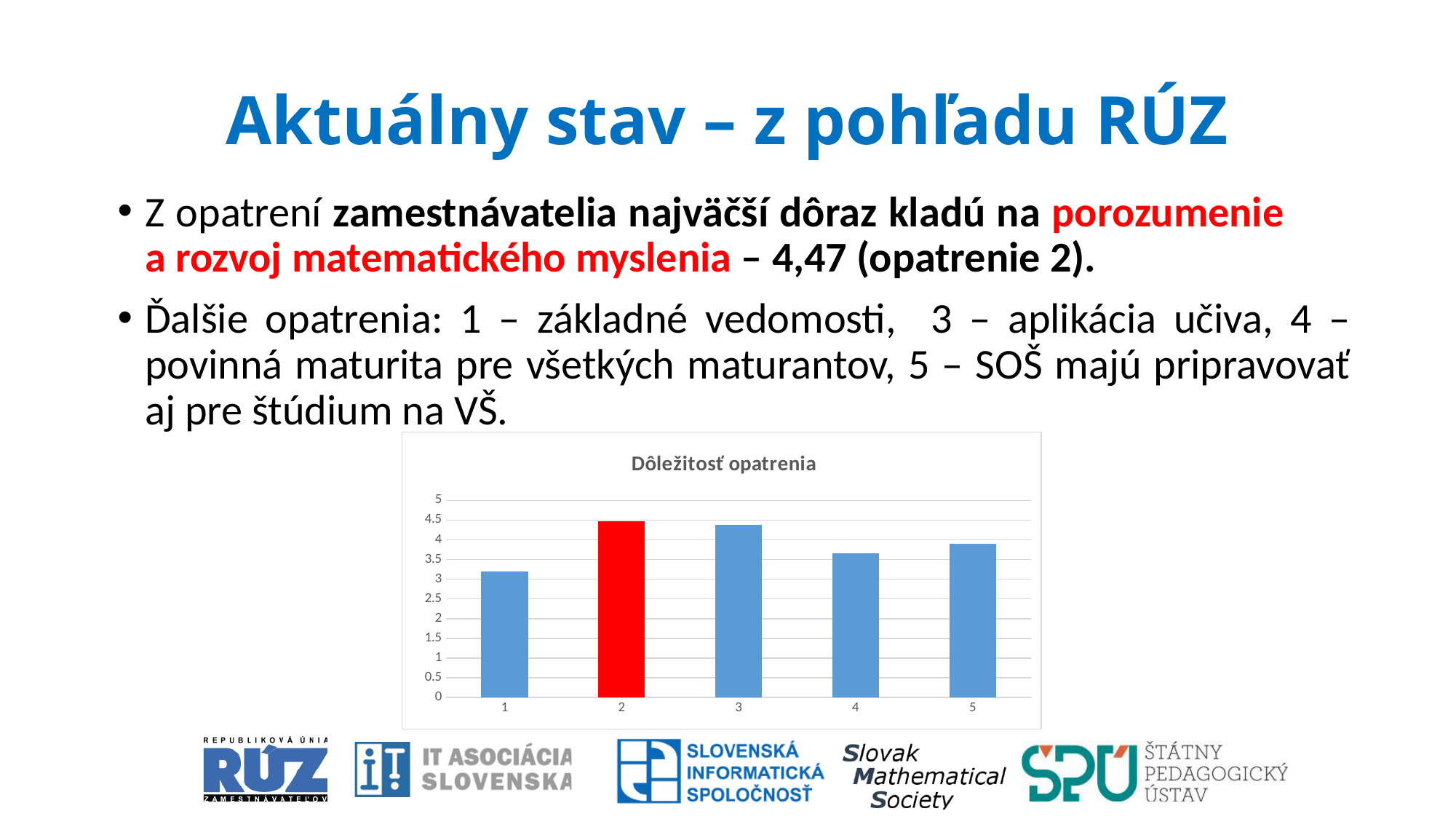
Which has the larger value, category 3 or category 5? 3 Which category has the highest bar in the chart? 2 Which bar in the chart is coloured red? 2 Is the value for category 3 greater or less than 4? greater What is the title of the chart? Dôležitosť opatrenia Which has the larger value, category 1 or category 4? 4 What kind of chart is shown on the slide? bar chart Which category has the lowest bar in the chart? 1 Is the value for category 4 greater or less than 4? less Is the value for category 5 greater or less than 3.5? greater How many categories (bars) does the chart show? 5